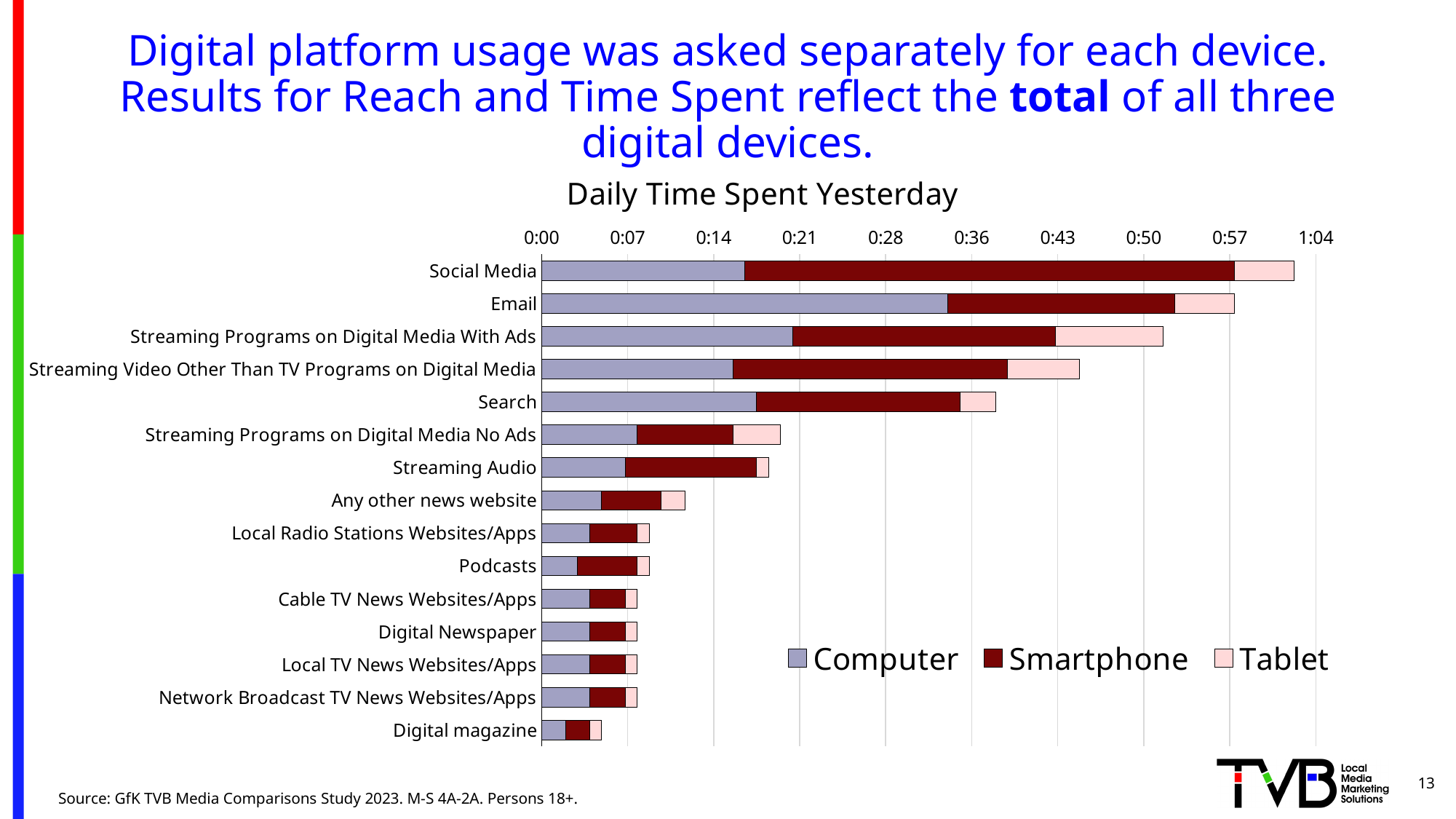
Which category has the longest total bar? Social Media Which has a longer total bar, Email or Streaming Programs on Digital Media With Ads? Email Which series are listed in the legend? Computer, Smartphone, Tablet Is the total value for Search greater or less than 0:43? less How many categories are plotted on the chart? 15 Which category has the shortest total bar? Digital magazine What kind of chart is shown on the slide? Stacked bar chart Is the total value for Social Media greater or less than 0:57? greater What is the title of the chart? Daily Time Spent Yesterday Which has a longer total bar, Social Media or Email? Social Media How many series does the legend list? 3 Is the Computer value for Email greater or less than 0:28? greater